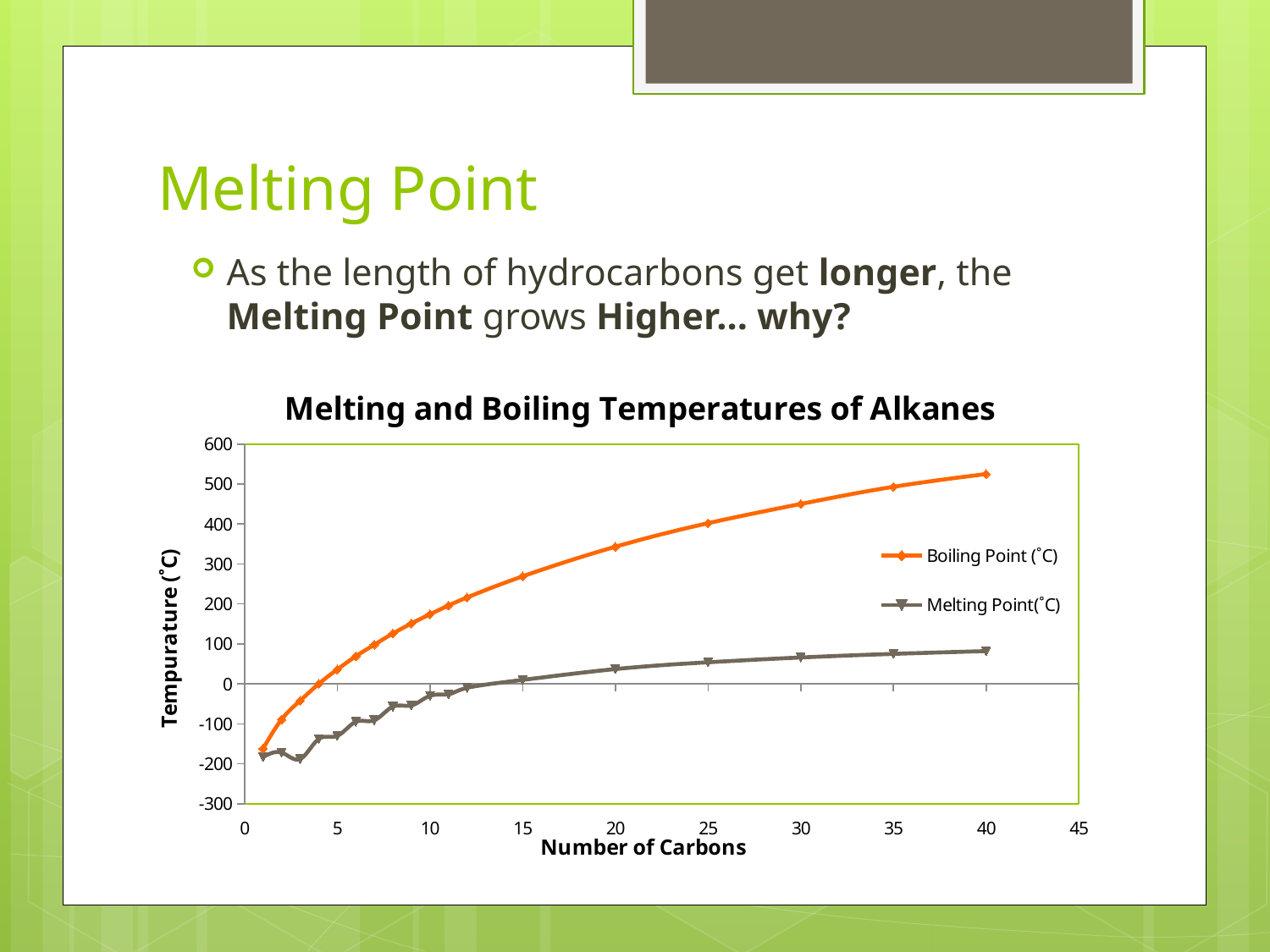
How many series does the legend list? 2 What is the title of the chart? Melting and Boiling Temperatures of Alkanes What kind of chart is shown on the slide? line chart Is the Boiling Point (˚C) value at 40 carbons greater or less than 500? greater Is the Boiling Point (˚C) value at 20 carbons greater or less than 300? greater What is the label of the x axis? Number of Carbons Does the Boiling Point (˚C) series rise or fall as the number of carbons increases? rise Is the Melting Point(˚C) value at 1 carbon greater or less than -100? less Does the Melting Point(˚C) series generally rise or fall as the number of carbons increases? rise At 30 carbons, which series has the higher value, Boiling Point (˚C) or Melting Point(˚C)? Boiling Point (˚C)